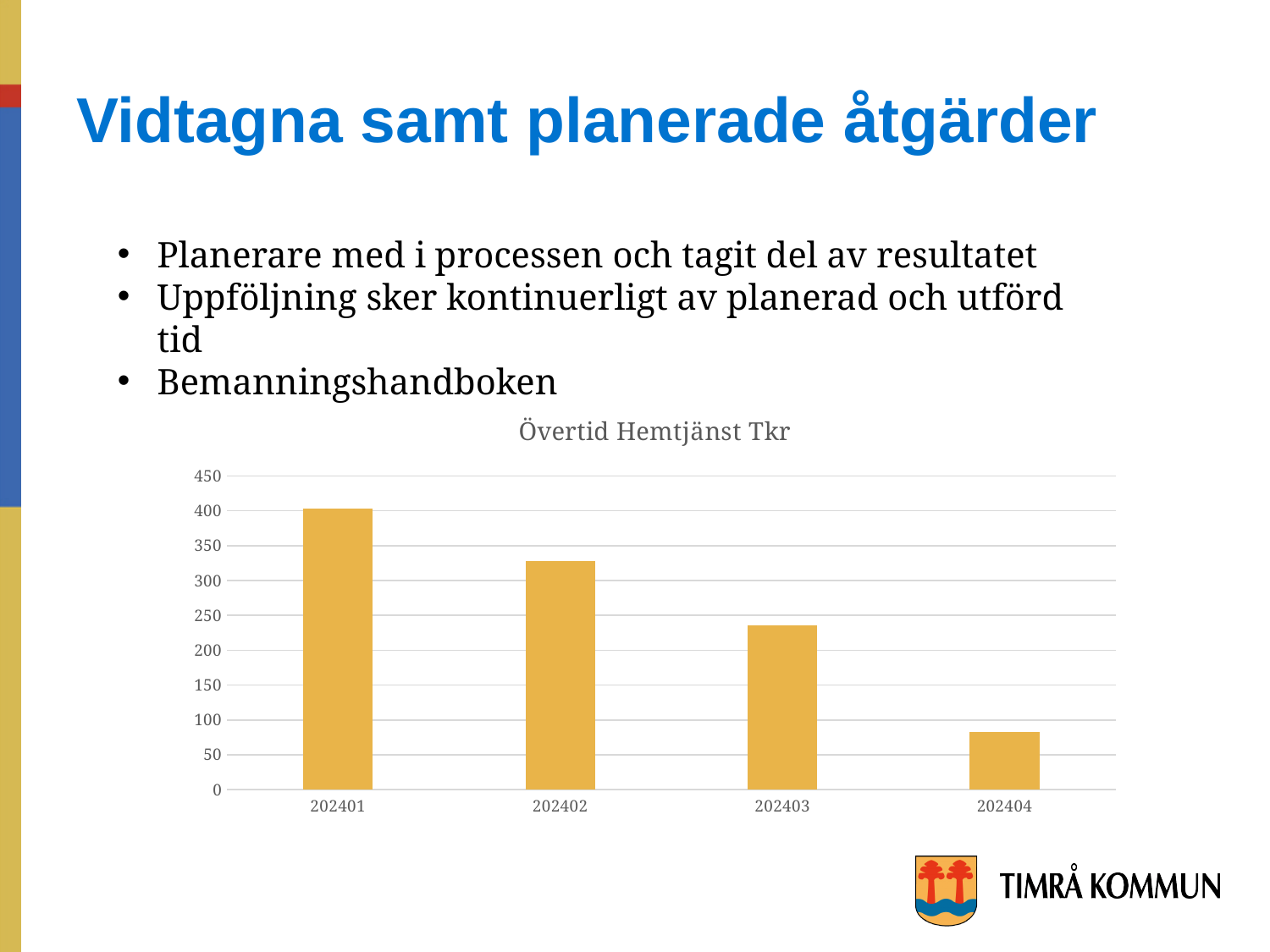
Do the values rise or fall from 202401 to 202404? fall What type of chart is shown on the slide? bar chart Which category has the lowest value in the chart? 202404 Is the value for 202402 greater or less than 350? less How many categories are shown on the x axis of the chart? 4 Is the value for 202401 greater or less than 350? greater Which category has the highest value in the chart? 202401 Is the value for 202404 greater or less than 100? less Which has the larger value, 202402 or 202403? 202402 What is the highest value shown on the vertical axis of the chart? 450 What is the title of the chart? Övertid Hemtjänst Tkr